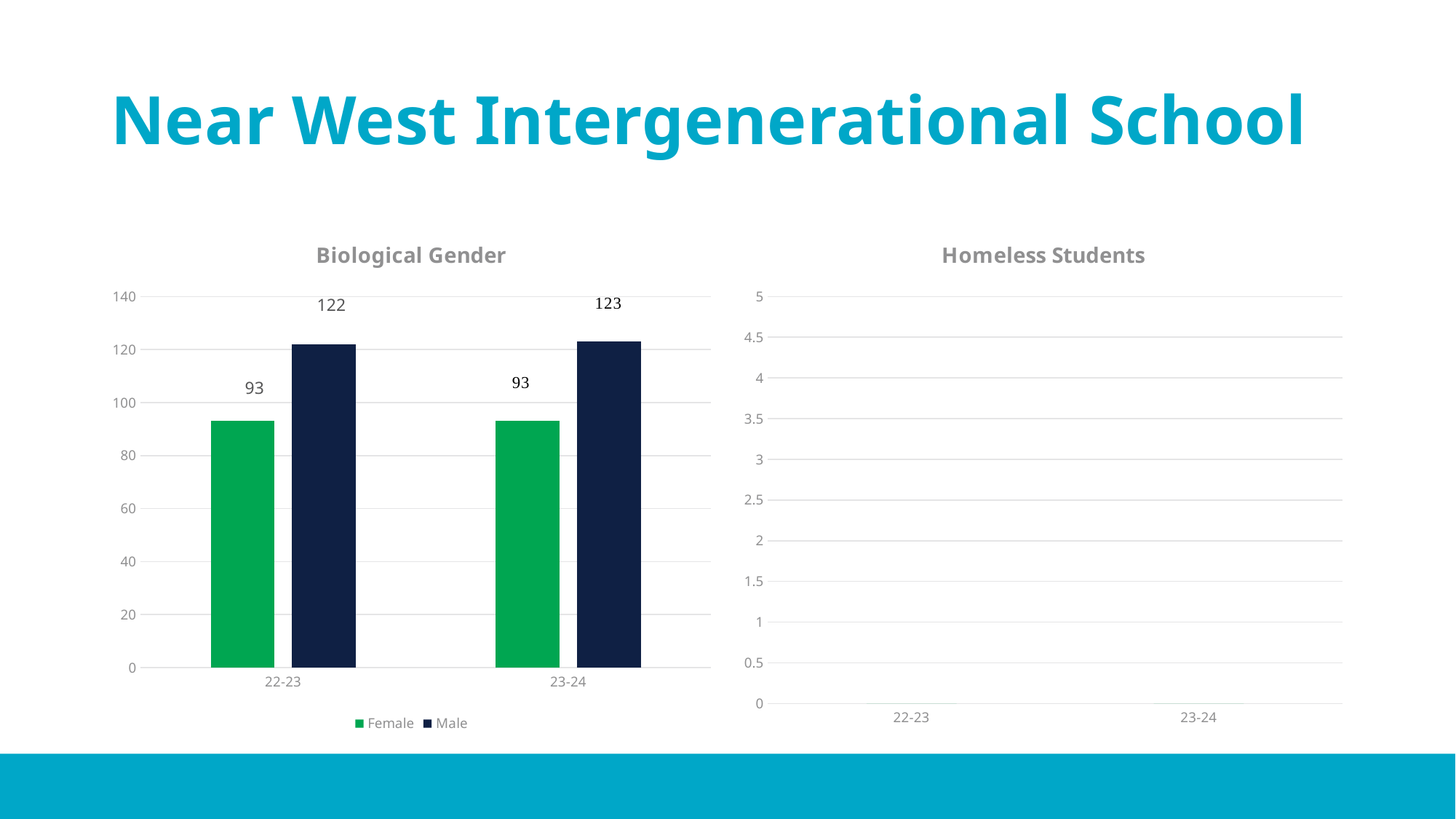
In the Biological Gender chart, which is larger for 23-24, Female or Male? Male In the Biological Gender chart, what is the difference between the Male and Female values for 23-24? 30 In the Biological Gender chart, is the Male value for 22-23 greater or less than 120? greater In the Biological Gender chart, what is the Male value for 22-23? 122 In the Biological Gender chart, what is the difference between the Male and Female values for 22-23? 29 How many series does the legend of the Biological Gender chart list? 2 What kind of chart is the Biological Gender chart? bar chart What is the title of the chart on the right side of the slide? Homeless Students In the Biological Gender chart, what is the Female value for 22-23? 93 In the Biological Gender chart, is the Female value for 23-24 greater or less than 100? less How many categories are shown on the x axis of the Biological Gender chart? 2 In the Biological Gender chart, what is the Male value for 23-24? 123